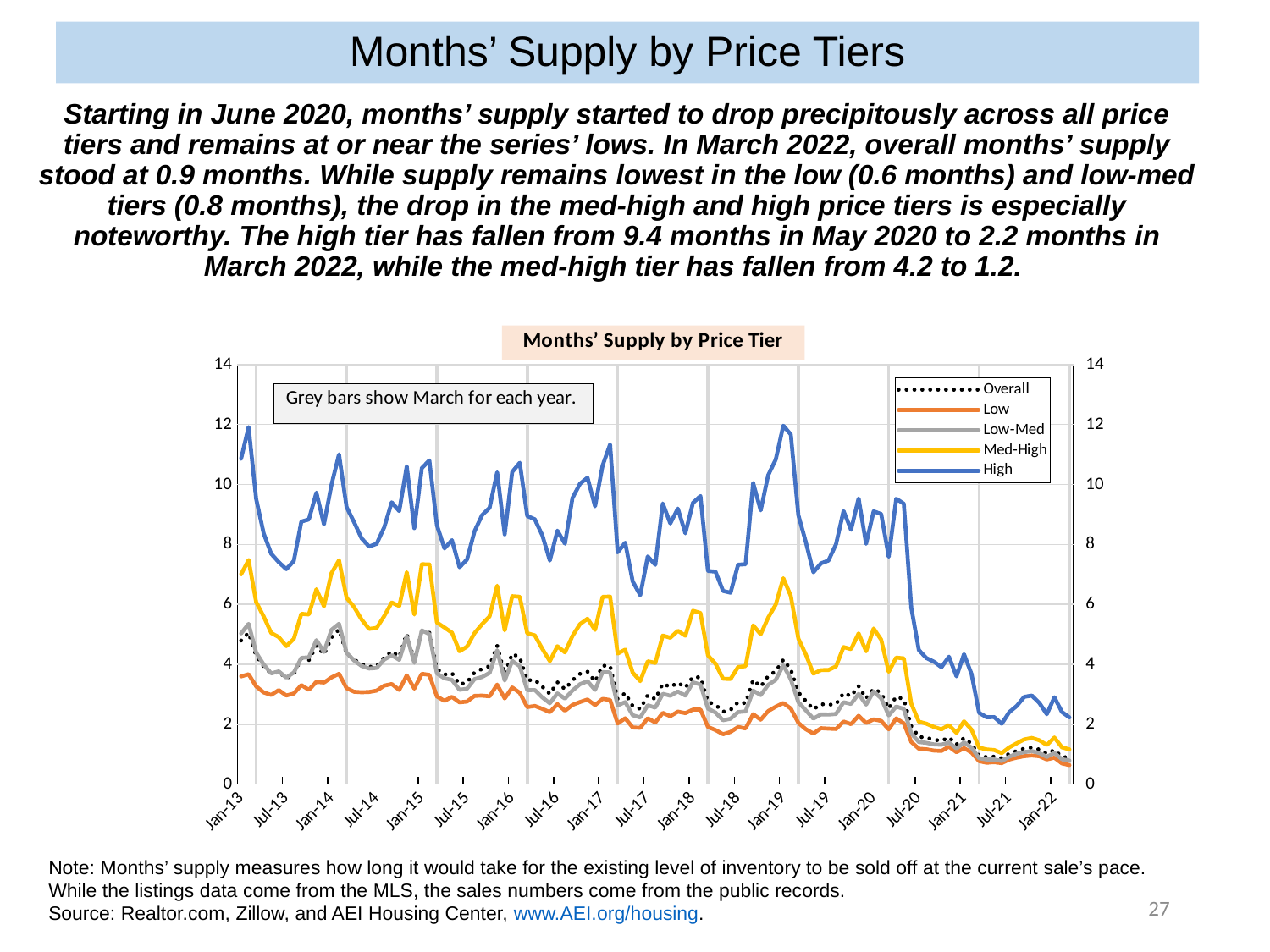
What kind of chart is shown on the slide? line chart Which series is plotted highest on the chart across the whole period? High Is the value of the High series at Jan-22 greater or less than 4? less How many series does the chart legend list? 5 Is the value of the Med-High series at Jan-13 greater or less than 6? greater Which series is plotted lowest on the chart across the whole period? Low What do the grey bars on the chart show? March for each year Is the value of the High series at Jan-13 greater or less than 10? greater According to the slide, what was overall months' supply in March 2022? 0.9 months According to the slide, what was the high tier's months' supply in May 2020? 9.4 months Does the High series rise or fall overall from Jan-13 to Jan-22? fall By how many months did the high tier fall from May 2020 (9.4) to March 2022 (2.2)? 7.2 months